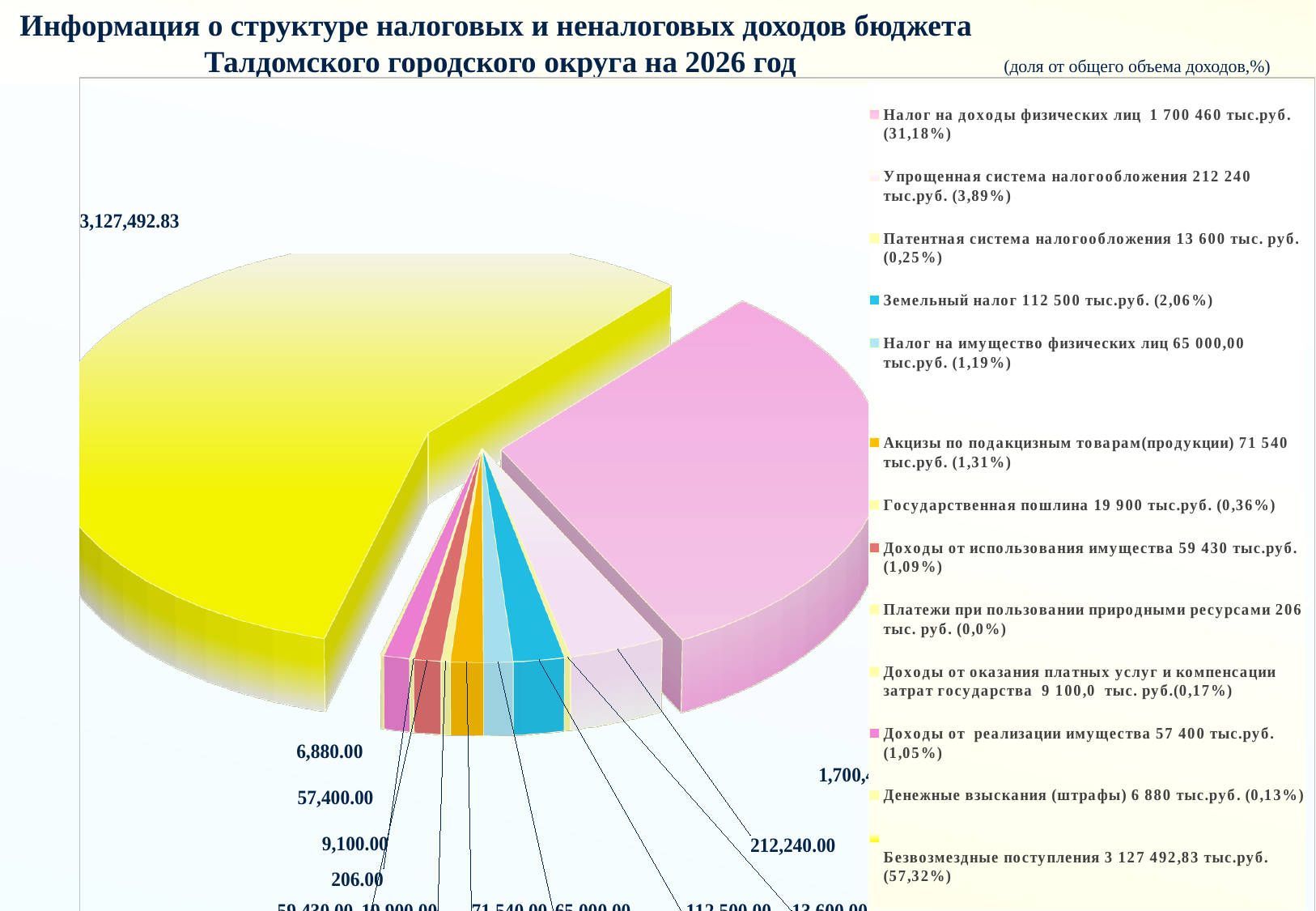
What is the value shown for Земельный налог in the legend? 112 500 тыс.руб. What is the value shown for Денежные взыскания (штрафы) in the legend? 6 880 тыс.руб. What is the value shown for Упрощенная система налогообложения in the legend? 212 240 тыс.руб. What share of total revenue does Налог на доходы физических лиц represent according to the legend? 31,18% Which is larger: Акцизы по подакцизным товарам or Налог на имущество физических лиц? Акцизы по подакцизным товарам Which category has the smallest slice of the pie chart? Платежи при пользовании природными ресурсами What is the data label shown on the chart for the largest slice (Безвозмездные поступления)? 3,127,492.83 What share of total revenue does Безвозмездные поступления represent according to the legend? 57,32% What kind of chart is shown on the slide? pie chart Which category has the largest slice of the pie chart? Безвозмездные поступления How many categories (slices) does the legend of the pie chart list? 13 What is the difference between Земельный налог (112 500 тыс.руб.) and Налог на имущество физических лиц (65 000,00 тыс.руб.)? 47 500 тыс.руб.